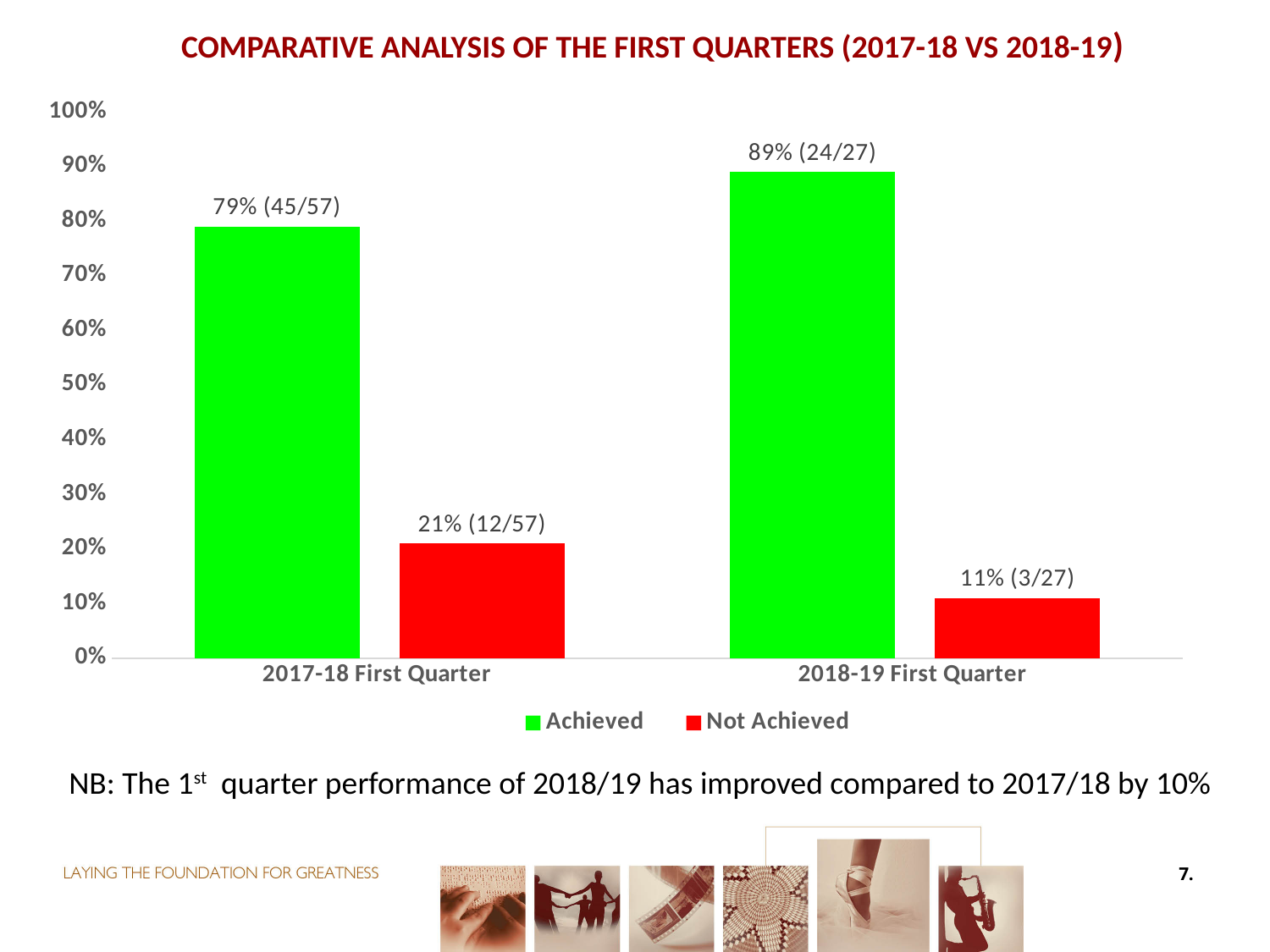
Is the Not Achieved value for 2017-18 First Quarter larger or smaller than the Not Achieved value for 2018-19 First Quarter? larger What is the Achieved value for 2017-18 First Quarter? 79% (45/57) Which quarter has the higher Achieved percentage? 2018-19 First Quarter What is the Not Achieved value for 2018-19 First Quarter? 11% (3/27) What is the Not Achieved value for 2017-18 First Quarter? 21% (12/57) By how many percentage points does the Achieved value for 2018-19 First Quarter exceed that of 2017-18 First Quarter? 10% What colour represents the Not Achieved series? red Which quarter has the lower Not Achieved percentage? 2018-19 First Quarter What kind of chart is shown on the slide? bar chart How many quarters (categories) are shown on the x axis? 2 How many series does the legend list? 2 What is the Achieved value for 2018-19 First Quarter? 89% (24/27)